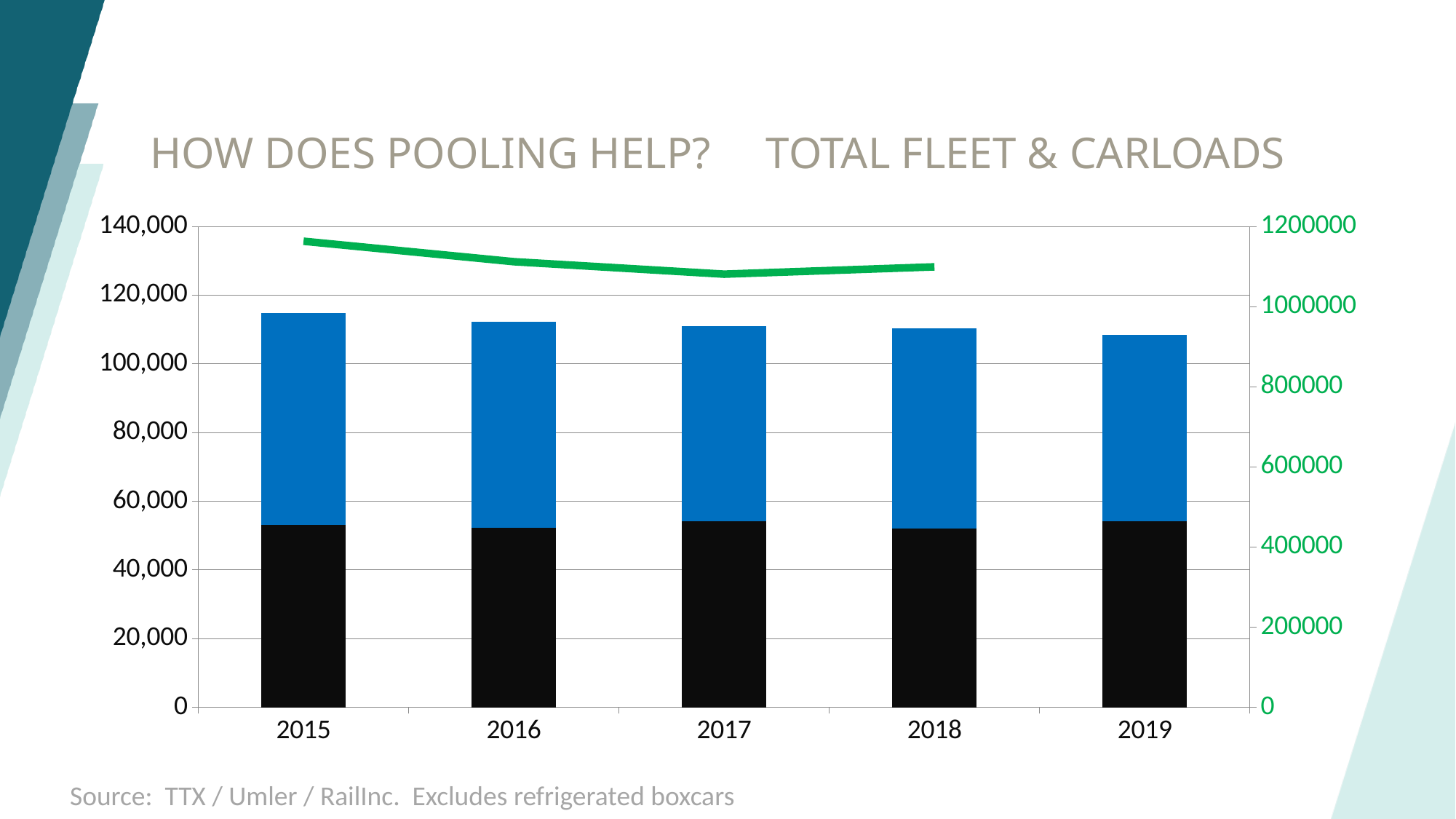
Which year has the shortest stacked bar? 2019 Which stacked bar is taller, 2015 or 2019? 2015 How many years are shown on the x axis of the chart? 5 Is the total stacked bar for 2015 greater or less than 100,000? greater Is the green line value for 2017 greater or less than 1200000 on the right axis? less Does the green line rise or fall from 2015 to 2017? Fall Which year has the tallest stacked bar? 2015 What kind of chart is shown on the slide? A stacked bar chart with a line What is the highest value shown on the right-hand (green) axis? 1200000 At which year does the green line reach its lowest point? 2017 Is the black segment of the 2015 bar greater or less than 60,000? less